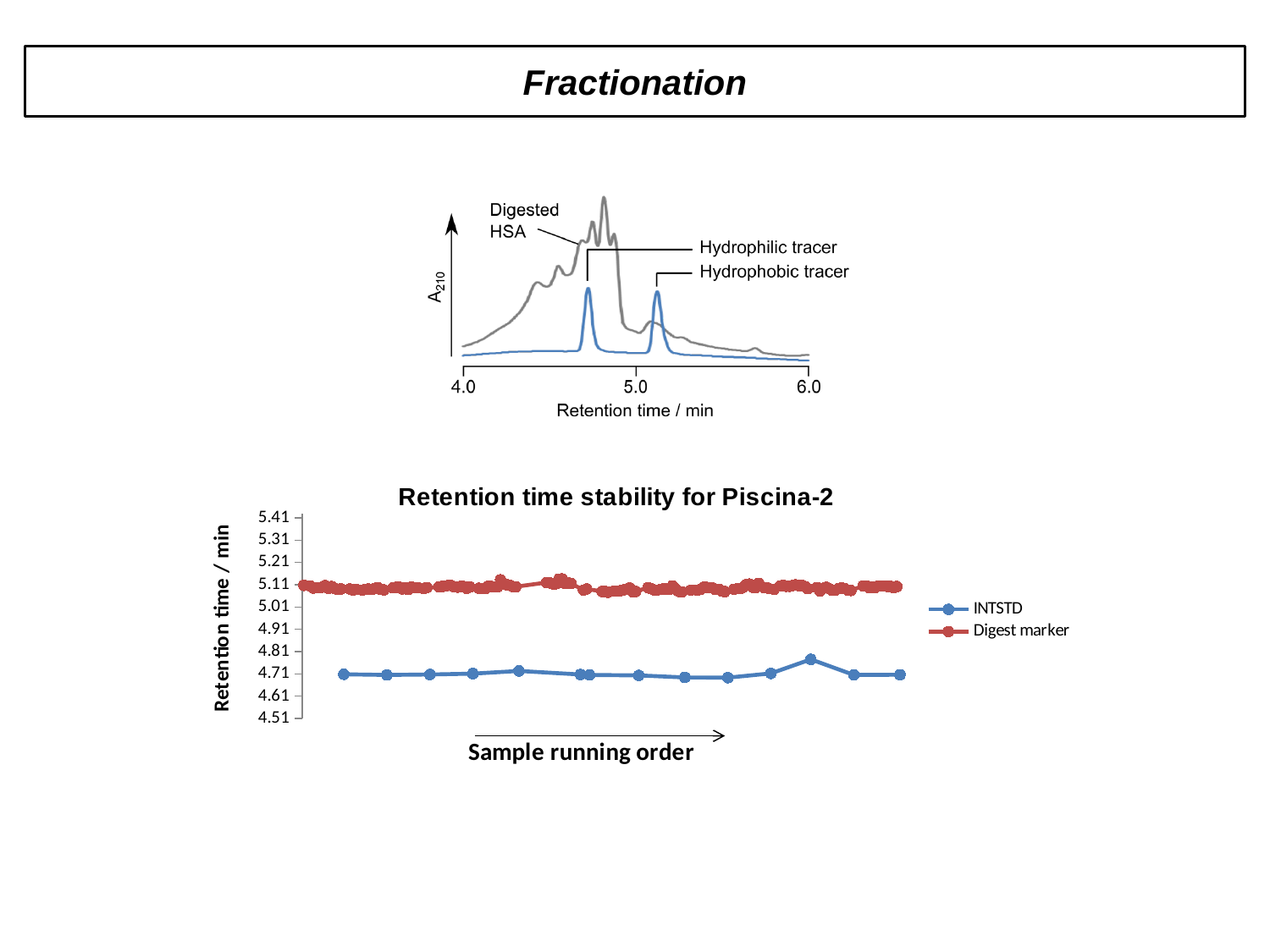
In the top chromatogram chart, which tracer peak appears at an earlier retention time, the Hydrophilic tracer or the Hydrophobic tracer? Hydrophilic tracer In the 'Retention time stability for Piscina-2' chart, are the Digest marker values greater or less than 5.21? less What kind of chart is the 'Retention time stability for Piscina-2' chart? line chart In the 'Retention time stability for Piscina-2' chart, which series has the higher retention time, INTSTD or Digest marker? Digest marker In the top chromatogram chart, what is the x-axis label? Retention time / min How many series does the legend of the 'Retention time stability for Piscina-2' chart list? 2 In the 'Retention time stability for Piscina-2' chart, are the INTSTD values greater or less than 4.81? less What are the two series named in the legend of the 'Retention time stability for Piscina-2' chart? INTSTD and Digest marker In the top chromatogram chart, is the retention time of the Hydrophilic tracer peak greater or less than 5.0 min? less What is the y-axis label of the 'Retention time stability for Piscina-2' chart? Retention time / min